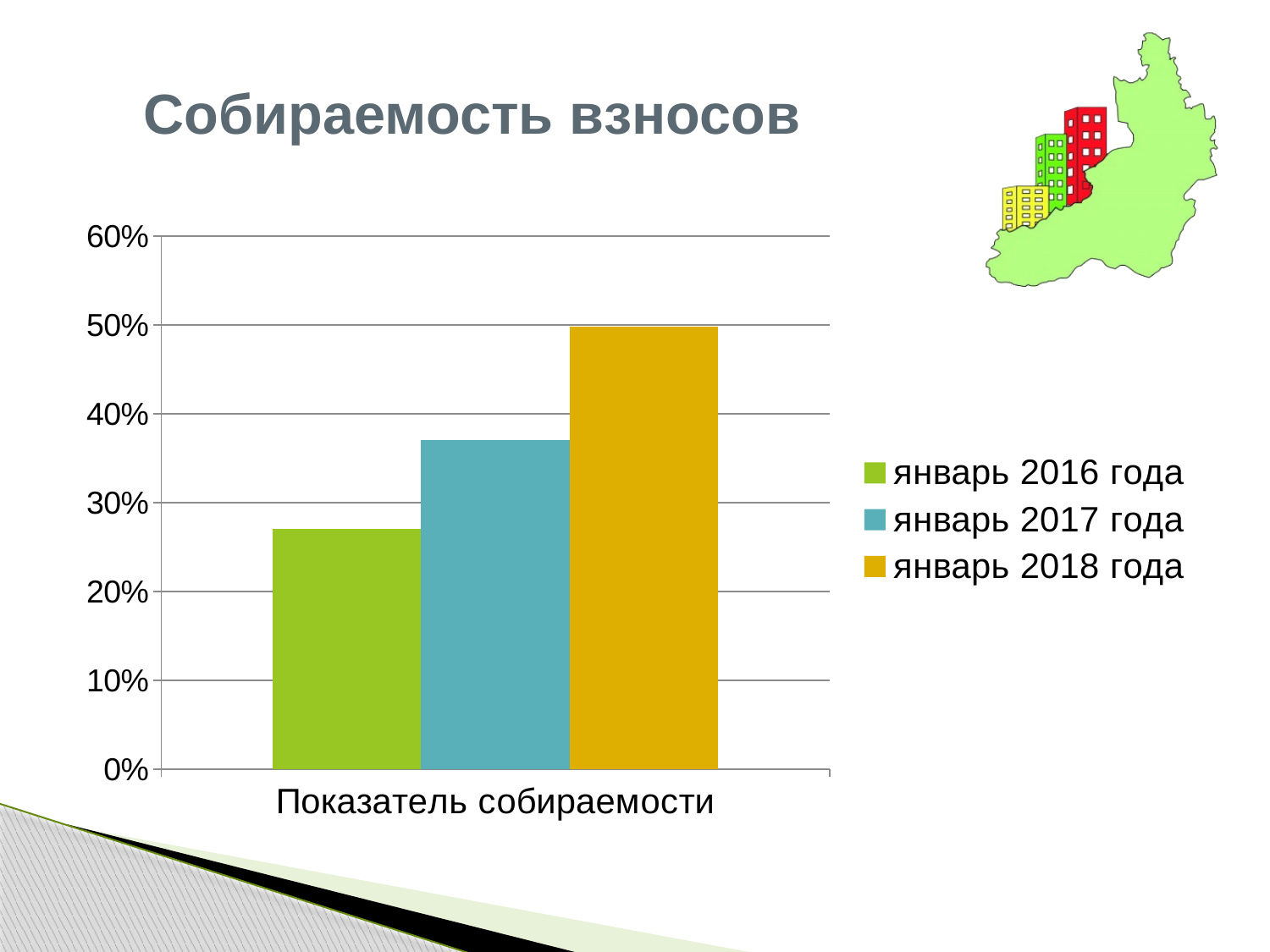
Which series has the highest value for Показатель собираемости? январь 2018 года Is the value for январь 2016 года greater or less than 30%? less Which is larger, the value for январь 2017 года or for январь 2016 года? январь 2017 года How many categories are shown on the x axis? 1 Which series has the lowest value for Показатель собираемости? январь 2016 года Do the values rise or fall from январь 2016 года to январь 2018 года? rise How many series does the legend list? 3 Is the value for январь 2017 года greater or less than 40%? less What kind of chart is shown on the slide? bar chart What is the title of the slide containing the chart? Собираемость взносов Is the value for январь 2017 года greater or less than 30%? greater